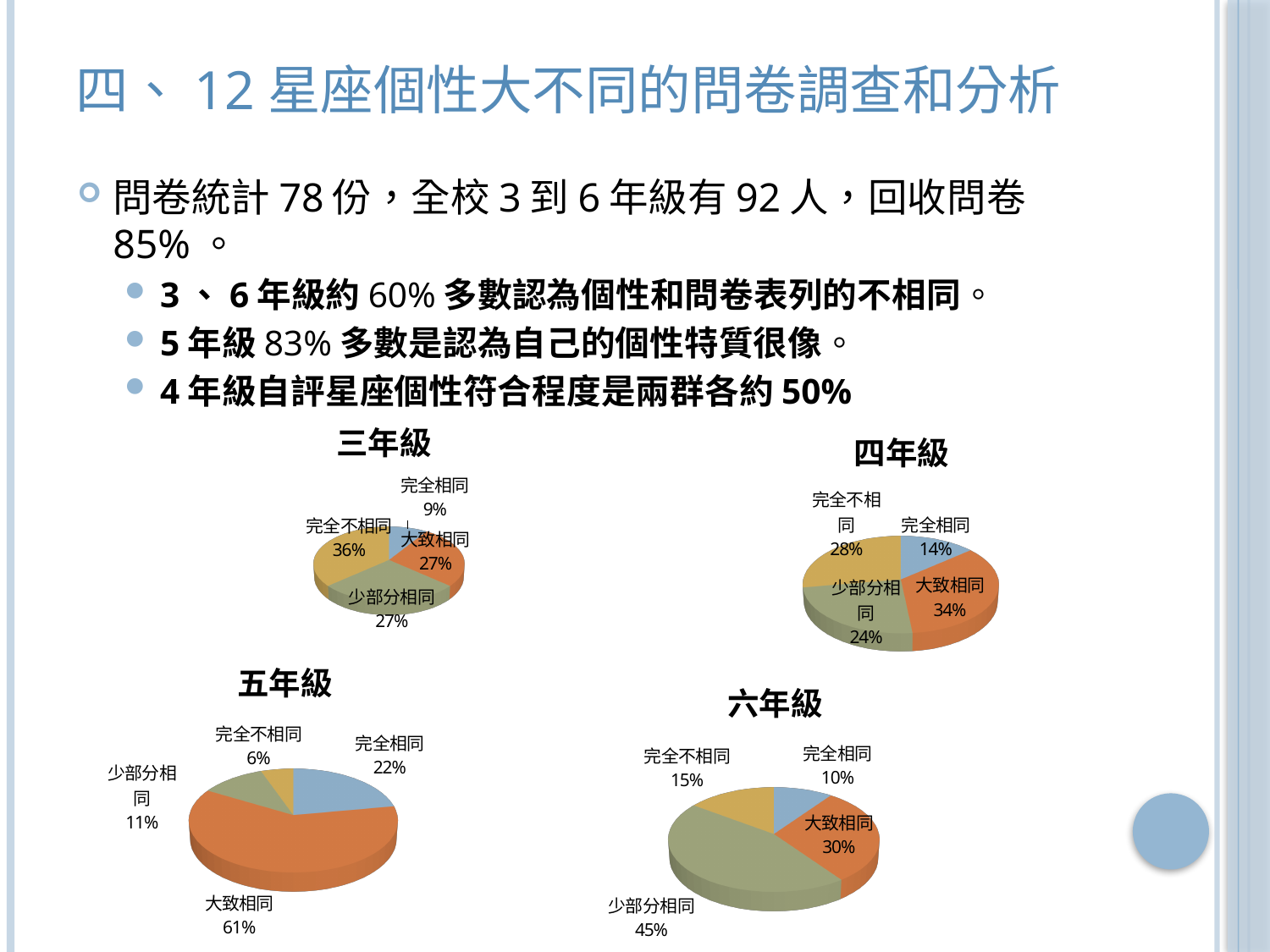
How many pie charts are shown on the slide? 4 In the 六年級 pie chart, what percentage is labelled 少部分相同? 45% What type of chart is used for 四年級? Pie chart In the 四年級 pie chart, what percentage is labelled 大致相同? 34% In the 五年級 pie chart, what percentage is labelled 完全相同? 22% In the 五年級 pie chart, which category has the largest share? 大致相同 In the 五年級 pie chart, which is larger: 少部分相同 or 完全不相同? 少部分相同 In the 四年級 pie chart, what is the difference between the 大致相同 share and the 完全相同 share? 20% How many categories does the 六年級 pie chart show? 4 In the 六年級 pie chart, which category has the smallest share? 完全相同 In the 三年級 pie chart, which category has the smallest share? 完全相同 In the 三年級 pie chart, what percentage is labelled 完全不相同? 36%